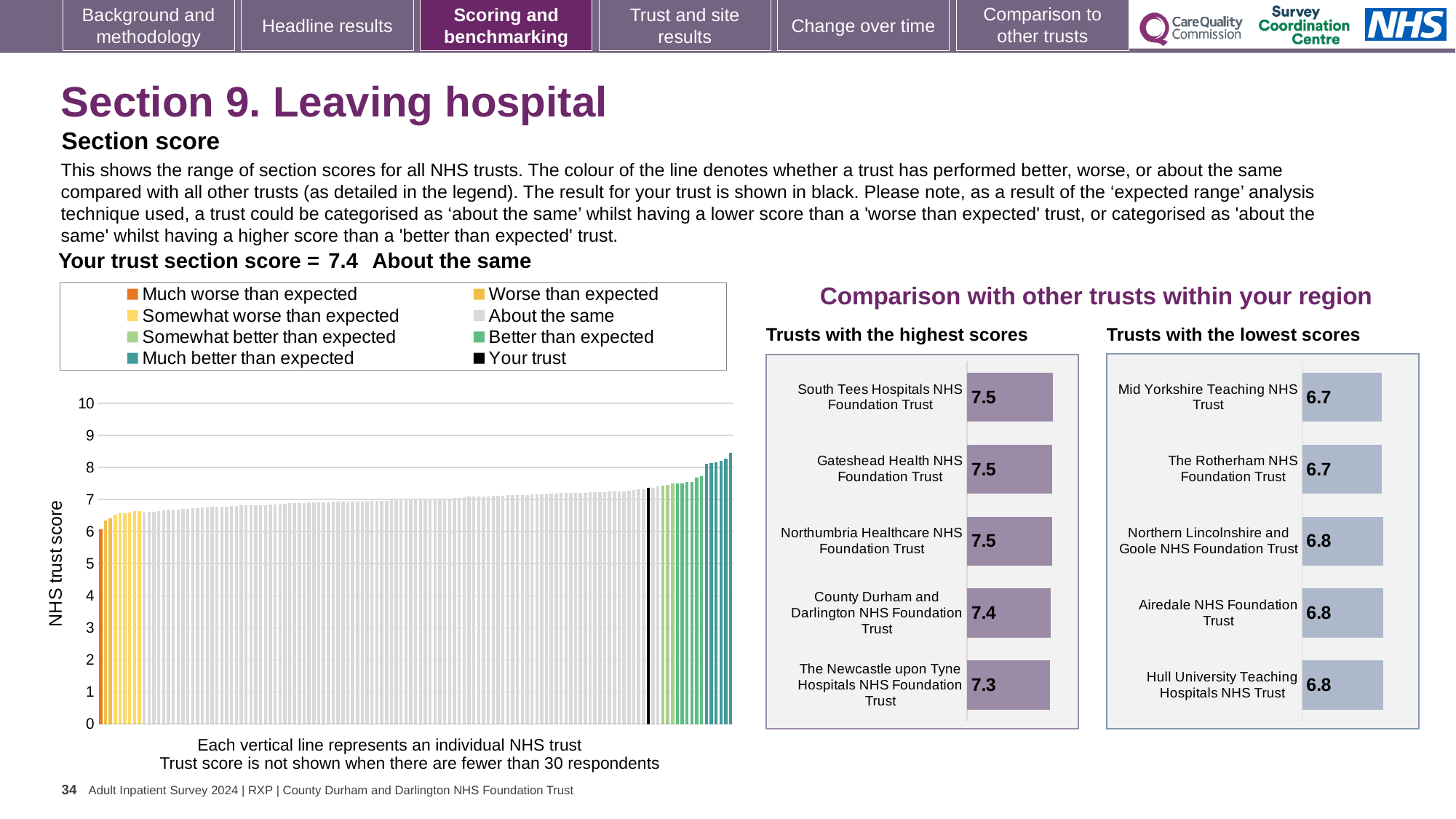
How many trusts are shown in the 'Trusts with the lowest scores' chart? 5 In the large chart on the left, what is the section score for your trust? 7.4 How many entries does the legend of the large chart on the left list? 8 In the 'Trusts with the lowest scores' chart, what is the score for Mid Yorkshire Teaching NHS Trust? 6.7 In the 'Trusts with the highest scores' chart, what is the score for South Tees Hospitals NHS Foundation Trust? 7.5 In the large chart on the left, is the value of the rightmost bar greater or less than 8? greater What kind of chart is the large chart on the left showing NHS trust scores? bar chart What is the label on the y axis of the large chart on the left? NHS trust score In the 'Trusts with the highest scores' chart, which trust has the lowest score? The Newcastle upon Tyne Hospitals NHS Foundation Trust In the large chart on the left, do the trust scores rise or fall from left to right along the x axis? rise In the 'Trusts with the highest scores' chart, what is the difference between the scores of Gateshead Health NHS Foundation Trust and The Newcastle upon Tyne Hospitals NHS Foundation Trust? 0.2 In the large chart on the left, is the value of the leftmost (orange) bar greater or less than 7? less